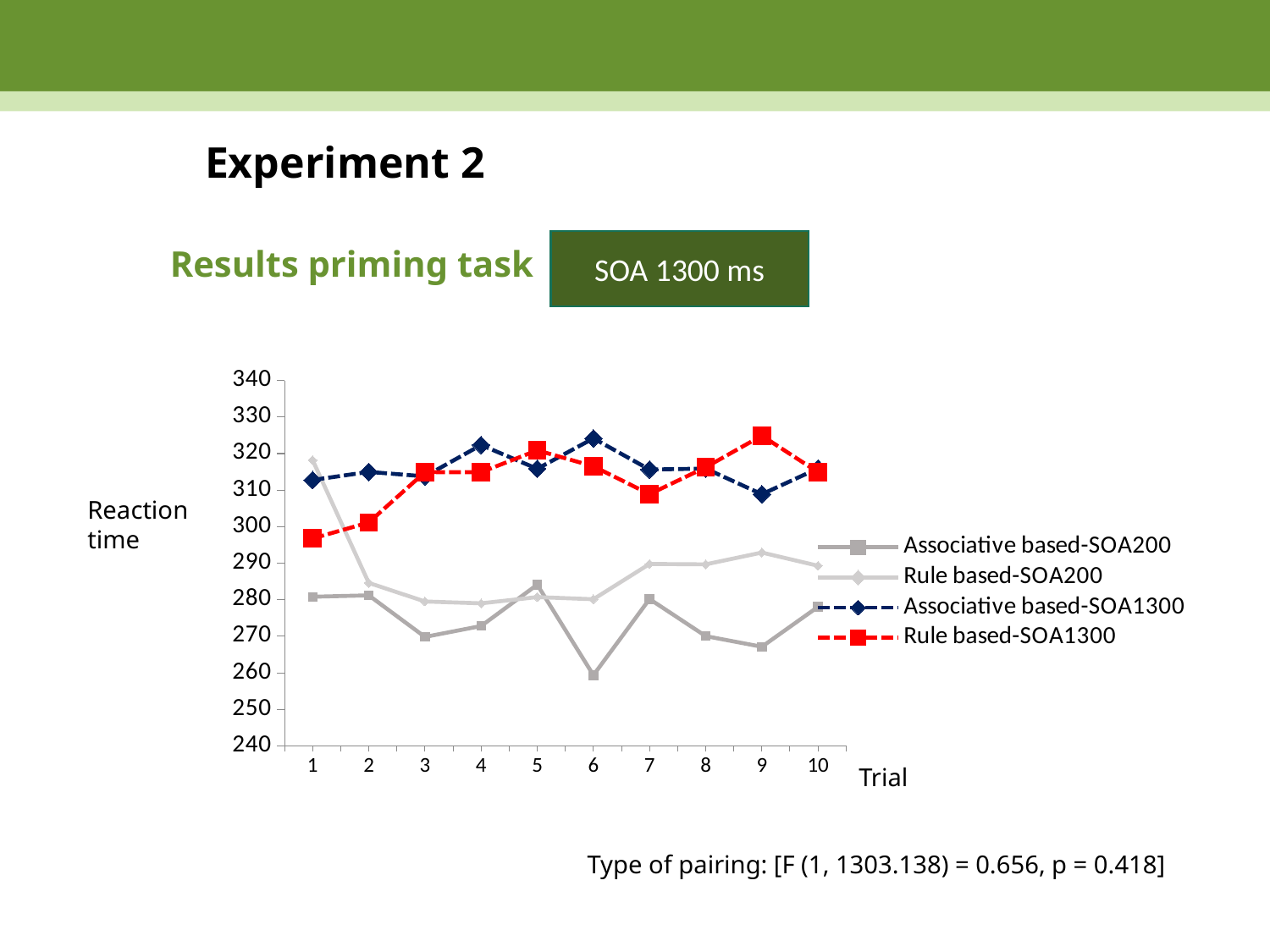
How many trials are plotted along the x axis? 10 Is the value for Associative based-SOA1300 at trial 6 greater or less than 320? greater At which trial does Rule based-SOA1300 reach its highest reaction time? Trial 9 What is the label on the x axis of the chart? Trial At trial 1, which series has the larger value: Rule based-SOA200 or Associative based-SOA200? Rule based-SOA200 Is the value for Rule based-SOA1300 at trial 1 greater or less than 310? less Is the value for Associative based-SOA200 at trial 6 greater or less than 270? less What kind of chart is shown on the slide? Line chart At which trial does Associative based-SOA200 reach its lowest reaction time? Trial 6 Does the Rule based-SOA1300 series rise or fall from trial 1 to trial 3? Rise How many series does the chart legend list? 4